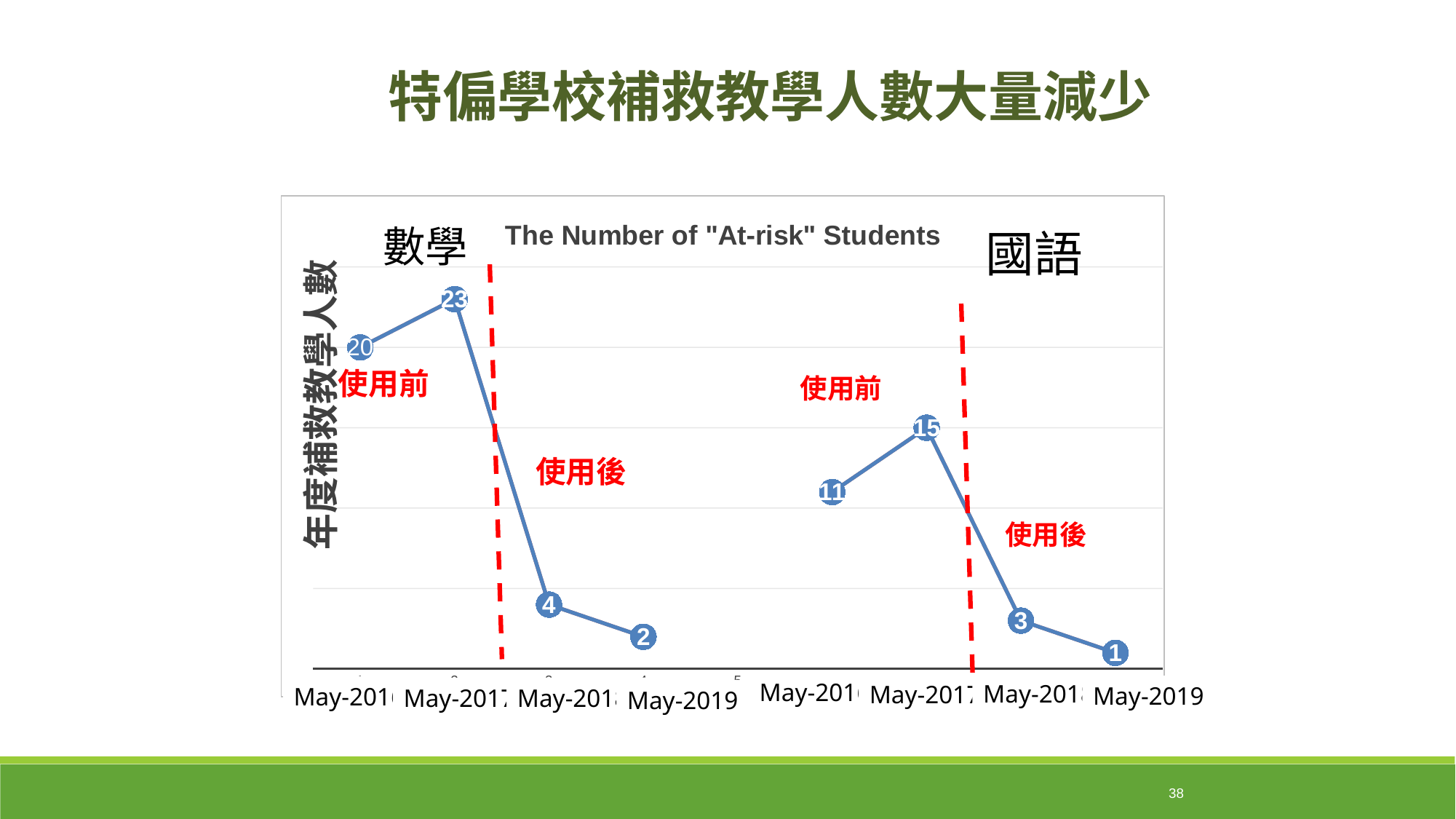
What is the difference between the peak value in the 數學 (Math) section (23) and the peak value in the 國語 (Chinese) section (15)? 8 What is the lowest value plotted in the 數學 (Math) section of the chart? 2 What is the highest value plotted in the 數學 (Math) section of the chart? 23 What is the value of the first plotted point in the 數學 (Math) section of the chart? 20 What is the highest value plotted in the 國語 (Chinese) section of the chart? 15 Which is larger: the May-2019 value for 數學 (Math) or the May-2019 value for 國語 (Chinese)? 數學 (Math) How many data points are plotted in the 數學 (Math) section of the chart? 4 In the 國語 (Chinese) section of the chart, what is the value for May-2019? 1 In the 數學 (Math) section of the chart, what is the value for May-2019? 2 What is the value of the first plotted point in the 國語 (Chinese) section of the chart? 11 What kind of chart is shown on the slide? line chart What is the title of the chart? The Number of "At-risk" Students